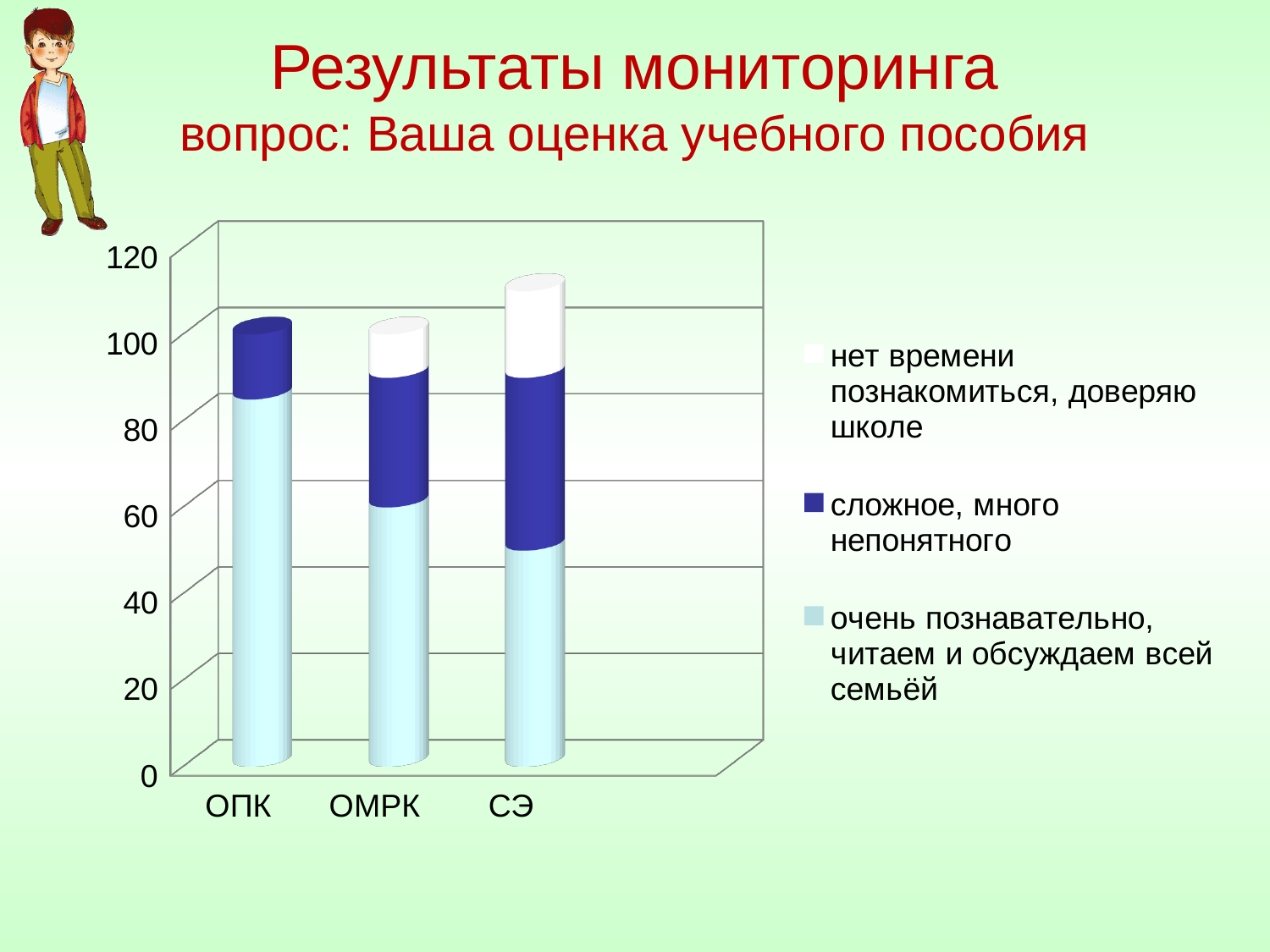
Which series is shown in dark blue in the legend? сложное, много непонятного What question do the monitoring results on the slide refer to? Ваша оценка учебного пособия What kind of chart is shown on the slide? bar chart How many series does the chart's legend list? 3 Which category has the tallest stacked bar overall? СЭ Which category has the largest segment for "очень познавательно, читаем и обсуждаем всей семьёй"? ОПК Is the value for "очень познавательно, читаем и обсуждаем всей семьёй" in СЭ greater or less than 60? less Is the total height of the stacked bar for СЭ greater or less than 100? greater Is the value for "очень познавательно, читаем и обсуждаем всей семьёй" in ОПК greater or less than 80? greater How many categories are shown on the x axis of the chart? 3 Which category has the smallest segment for "очень познавательно, читаем и обсуждаем всей семьёй"? СЭ Which category has the largest segment for "нет времени познакомиться, доверяю школе"? СЭ